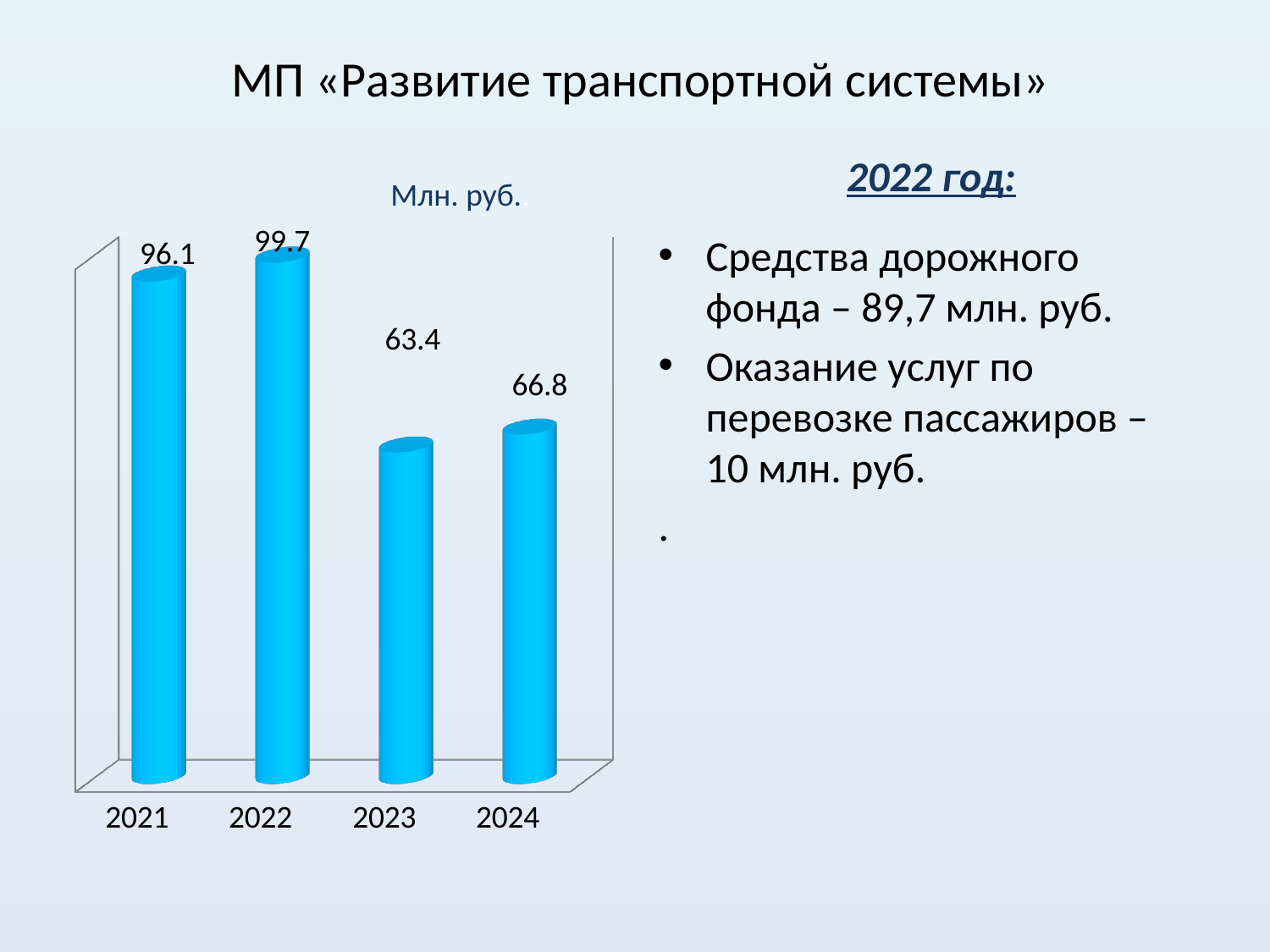
What unit is shown above the chart? Млн. руб. Which year has the highest value? 2022 What is the value for 2021? 96.1 How many years are shown on the chart? 4 Do the values rise or fall from 2022 to 2023? fall What is the value for 2023? 63.4 What kind of chart is shown on the slide? bar chart What is the value for 2024? 66.8 Which year has the lowest value? 2023 Which is larger, the value for 2021 or the value for 2024? 2021 What is the difference between the values for 2024 and 2023? 3.4 What is the difference between the values for 2022 and 2021? 3.6